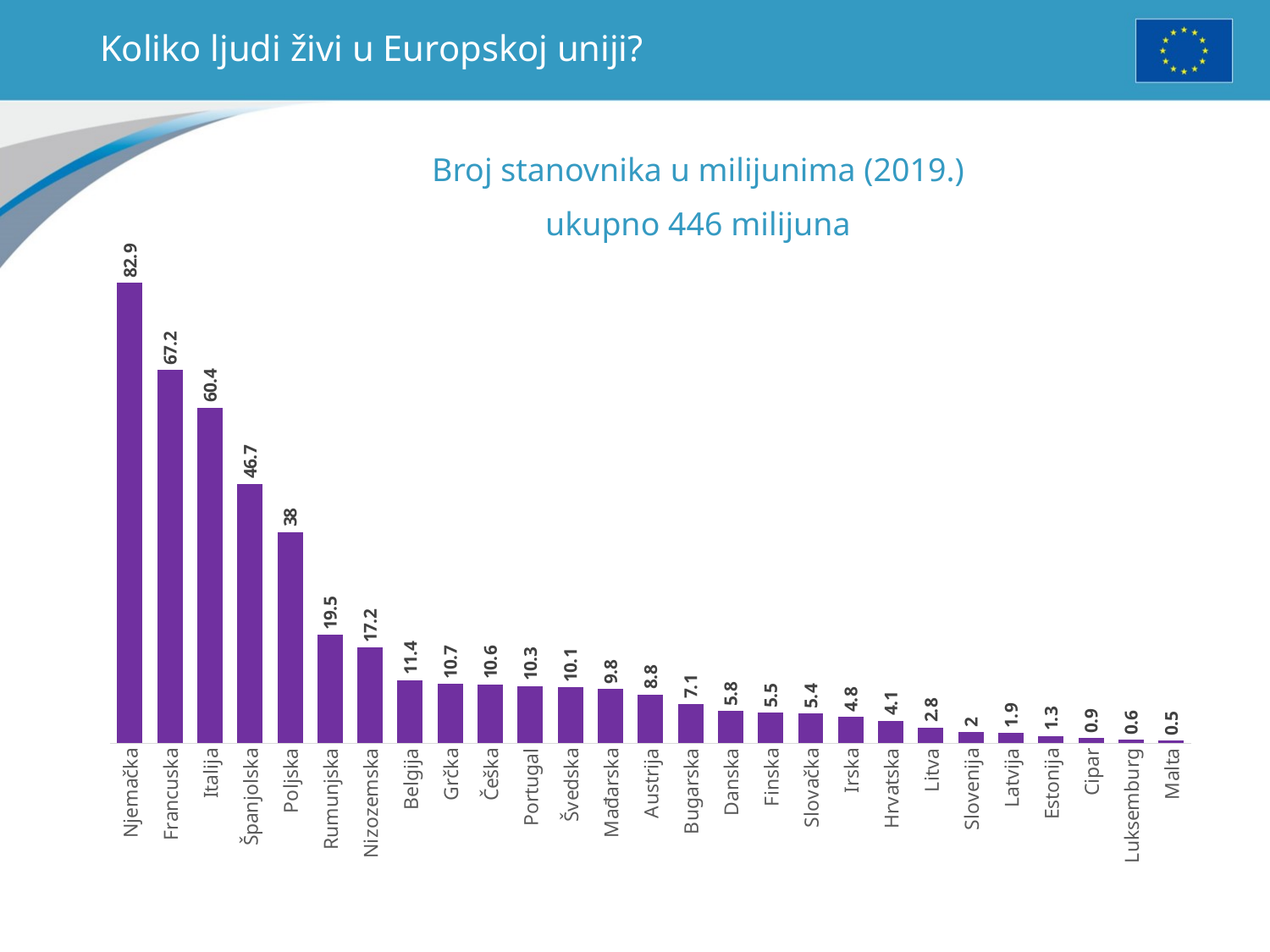
What is the population value shown for Njemačka? 82.9 What is the difference between the values for Francuska and Italija? 6.8 What is the difference between the values for Španjolska and Poljska? 8.7 Which country has the highest value in the chart? Njemačka What value is shown for Hrvatska? 4.1 Which has a larger value, Belgija or Austrija? Belgija What kind of chart is shown on the slide? Bar chart Which country has the lowest value in the chart? Malta What is the title of the chart? Broj stanovnika u milijunima (2019.) ukupno 446 milijuna What value is shown for Poljska? 38 Which has a larger value, Rumunjska or Nizozemska? Rumunjska How many countries are shown in the chart? 27